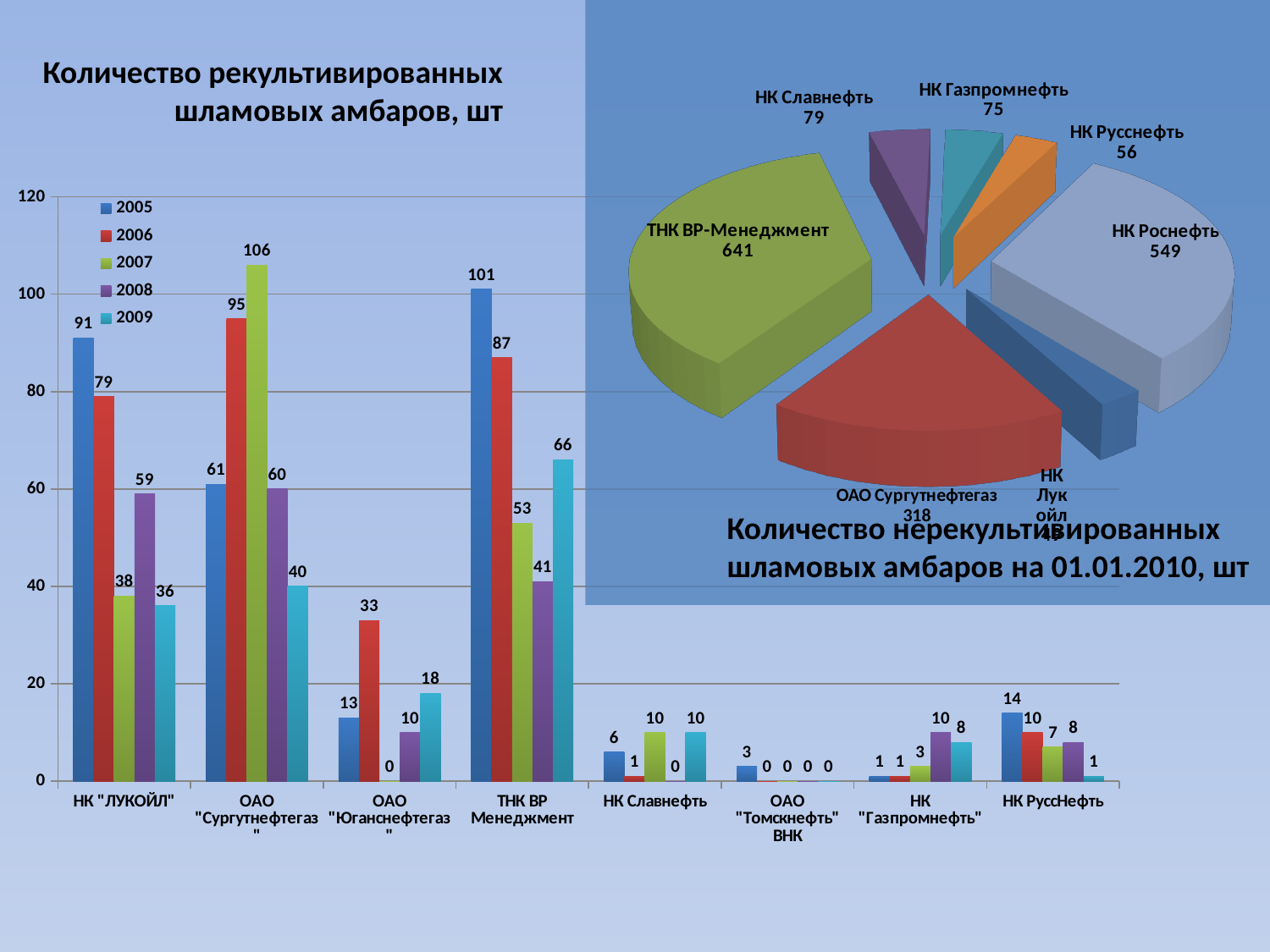
In the pie chart 'Количество нерекультивированных шламовых амбаров на 01.01.2010, шт', what is the difference between the values for НК Славнефть and НК Русснефть? 23 In the pie chart 'Количество нерекультивированных шламовых амбаров на 01.01.2010, шт', what is the value for НК Роснефть? 549 In the bar chart 'Количество рекультивированных шламовых амбаров, шт', which company has the highest value in 2005? ТНК ВР Менеджмент In the bar chart 'Количество рекультивированных шламовых амбаров, шт', what is the value for ОАО "Томскнефть" ВНК in 2005? 3 In the pie chart 'Количество нерекультивированных шламовых амбаров на 01.01.2010, шт', which company has the largest slice? ТНК ВР-Менеджмент How many companies are shown on the x axis of the bar chart 'Количество рекультивированных шламовых амбаров, шт'? 8 In the bar chart 'Количество рекультивированных шламовых амбаров, шт', what is the value for ОАО "Сургутнефтегаз" in 2007? 106 In the bar chart 'Количество рекультивированных шламовых амбаров, шт', which is larger: the 2006 value for НК "ЛУКОЙЛ" or the 2006 value for ОАО "Сургутнефтегаз"? ОАО "Сургутнефтегаз" In the bar chart 'Количество рекультивированных шламовых амбаров, шт', what is the difference between the 2005 and 2009 values for ТНК ВР Менеджмент? 35 In the bar chart 'Количество рекультивированных шламовых амбаров, шт', what is the value for НК "ЛУКОЙЛ" in 2005? 91 What kind of chart is the one on the left titled 'Количество рекультивированных шламовых амбаров, шт'? bar chart How many series does the legend of the bar chart 'Количество рекультивированных шламовых амбаров, шт' list? 5